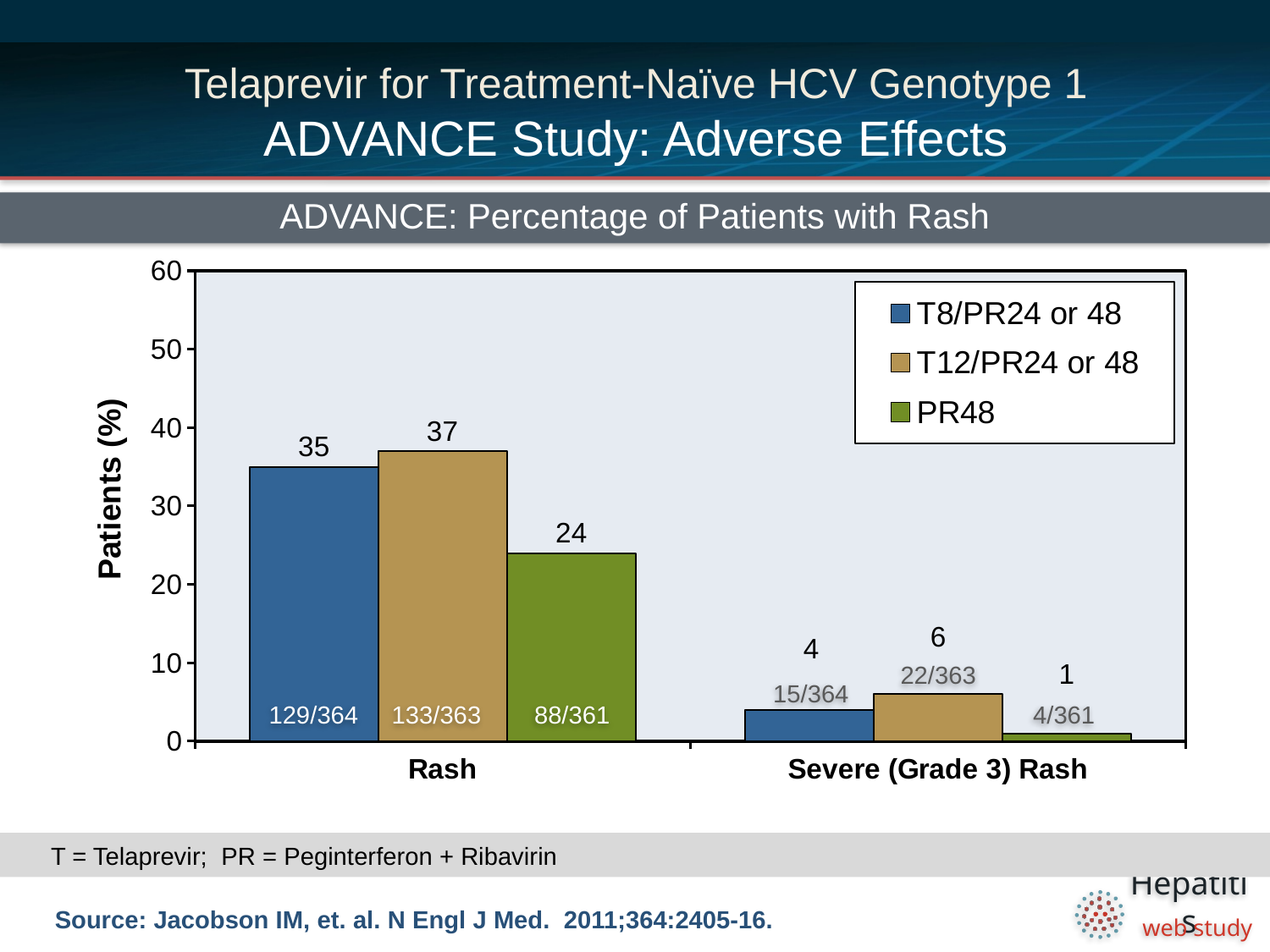
Which treatment group had the highest percentage of patients with rash? T12/PR24 or 48 Which is larger: the severe (Grade 3) rash percentage for T8/PR24 or 48 or for T12/PR24 or 48? T12/PR24 or 48 What is the title of the chart? ADVANCE: Percentage of Patients with Rash What percentage of patients in the T8/PR24 or 48 group had a rash? 35 Which treatment group had the lowest percentage of patients with severe (Grade 3) rash? PR48 What percentage of patients in the PR48 group had a severe (Grade 3) rash? 1 How many treatment groups does the legend list? 3 What is the difference in rash percentage between the T12/PR24 or 48 group and the PR48 group? 13 What kind of chart is shown on the slide? Bar chart What percentage of patients in the T12/PR24 or 48 group had a rash? 37 How many categories are shown on the x axis? 2 What is the fraction label shown on the PR48 bar for rash? 88/361